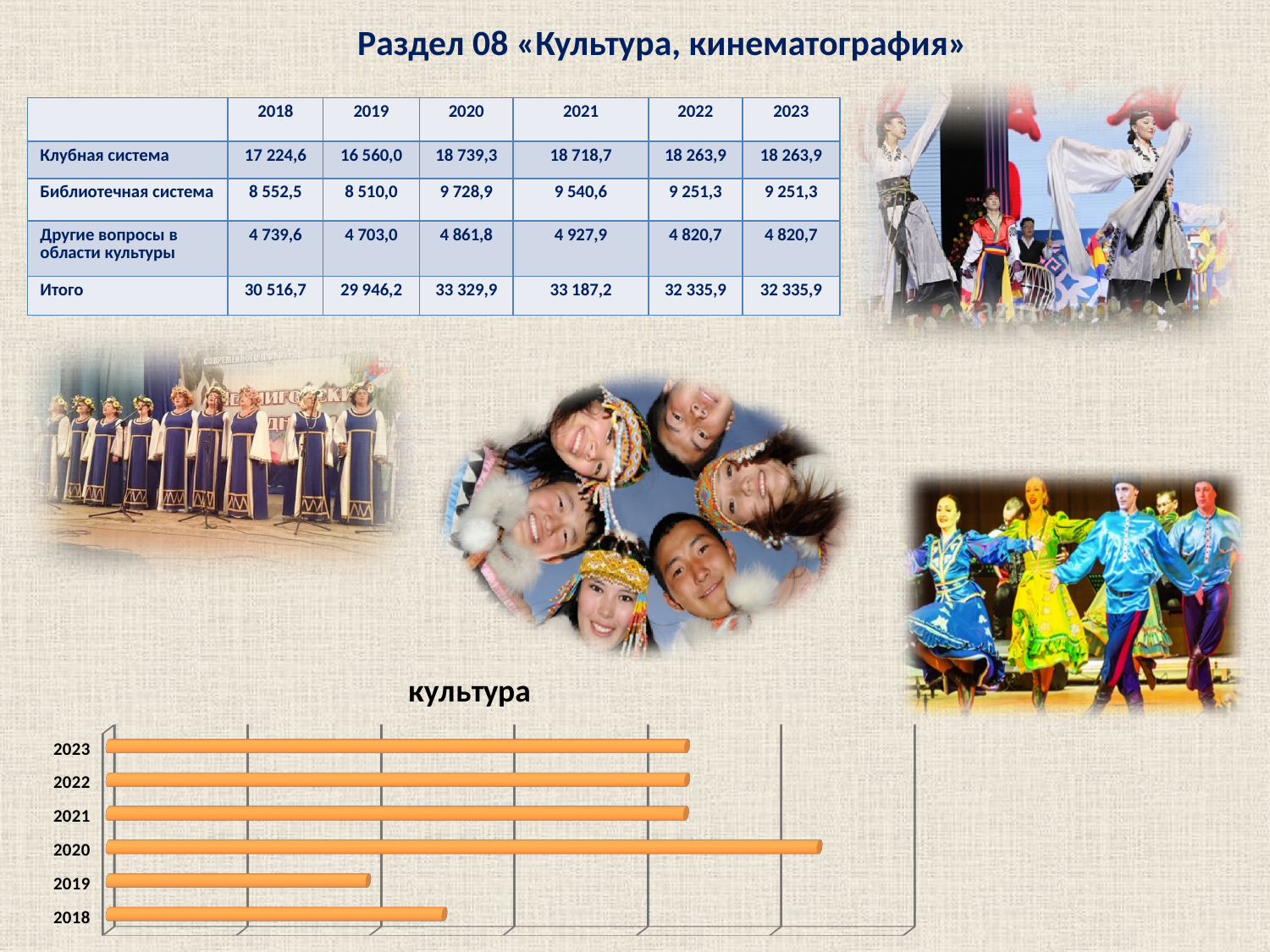
What kind of chart is shown at the bottom of the slide? bar chart Which year has the shortest bar on the chart? 2019 On the chart, which bar is longer: 2020 or 2019? 2020 How many categories (years) are shown on the chart? 6 On the chart, which bar is longer: 2021 or 2018? 2021 On the chart, which bar is longer: 2020 or 2023? 2020 What colour are the bars on the chart? orange What is the title of the chart at the bottom of the slide? культура Which year has the longest bar on the chart? 2020 Which year is listed at the top of the chart's category axis? 2023